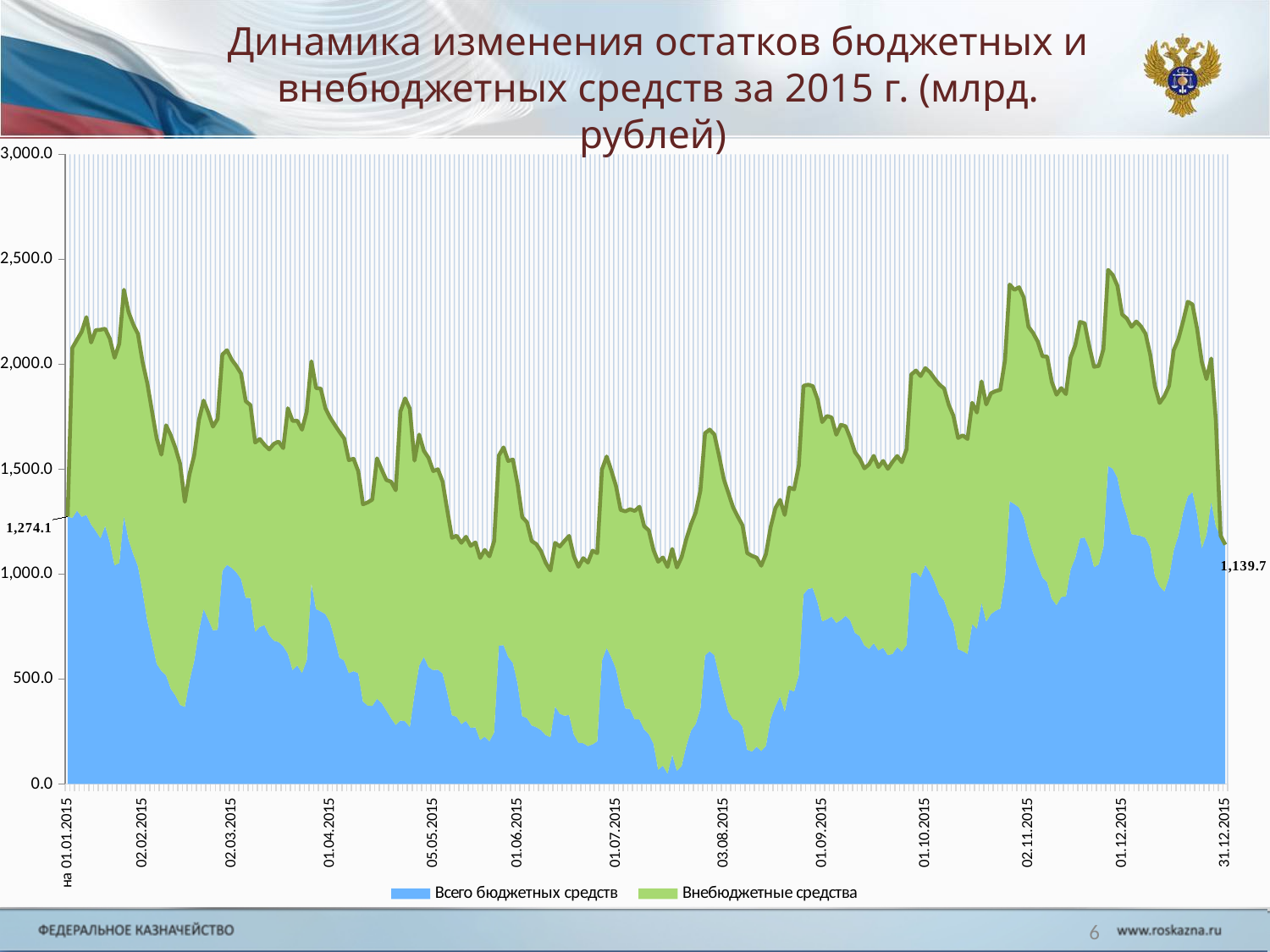
What kind of chart is shown on the slide? Area chart By how much did Всего бюджетных средств decrease from 01.01.2015 to 31.12.2015? 134.4 How many date labels are shown on the x axis? 13 Is the combined total of both series on 01.12.2015 greater or less than 2,000.0? greater What is the value of Всего бюджетных средств on 31.12.2015? 1,139.7 What is the value of Всего бюджетных средств on 01.01.2015? 1,274.1 Does the labelled value of Всего бюджетных средств rise or fall between 01.01.2015 and 31.12.2015? Fall Is the value for Всего бюджетных средств on 01.07.2015 greater or less than 1,000.0? less What is the title of the chart? Динамика изменения остатков бюджетных и внебюджетных средств за 2015 г. (млрд. рублей) Which date has the larger labelled value for Всего бюджетных средств, 01.01.2015 or 31.12.2015? 01.01.2015 How many series does the legend list? 2 What colour represents Внебюджетные средства in the chart? Green